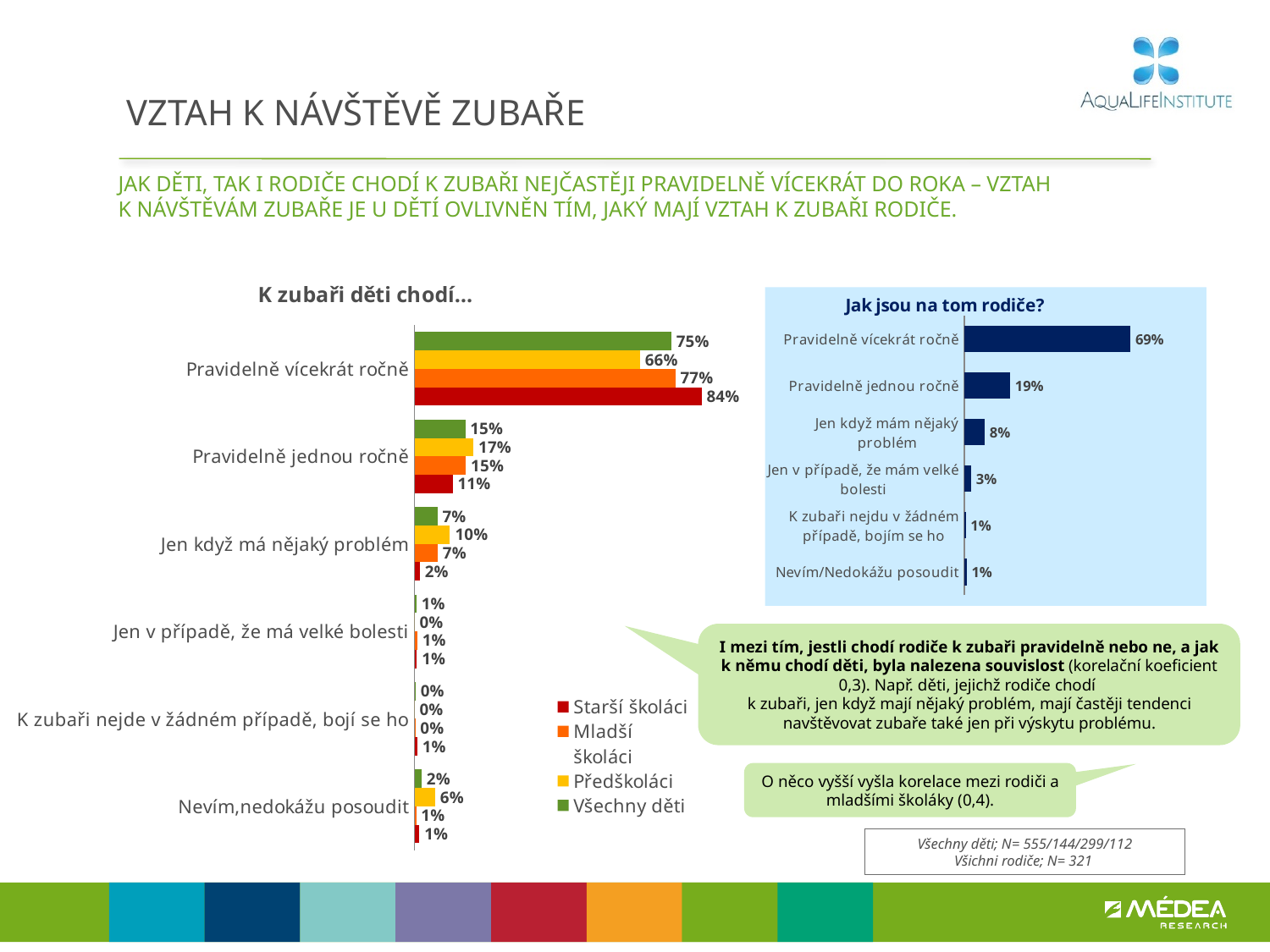
In the chart 'K zubaři děti chodí…', what is the difference between 'Mladší školáci' and 'Předškoláci' for 'Pravidelně vícekrát ročně'? 11% In the chart 'K zubaři děti chodí…', which series has the highest value for 'Pravidelně vícekrát ročně'? Starší školáci In the chart 'K zubaři děti chodí…', how many series does the legend list? 4 In the chart 'Jak jsou na tom rodiče?', which category has the highest value? Pravidelně vícekrát ročně In the chart 'Jak jsou na tom rodiče?', what is the value for 'Jen když mám nějaký problém'? 8% In the chart 'K zubaři děti chodí…', what is the value for 'Starší školáci' in 'Pravidelně vícekrát ročně'? 84% In the chart 'K zubaři děti chodí…', what is the value for 'Předškoláci' in 'Nevím,nedokážu posoudit'? 6% In the chart 'Jak jsou na tom rodiče?', what is the value for 'Pravidelně vícekrát ročně'? 69% In the chart 'K zubaři děti chodí…', which is larger for 'Jen když má nějaký problém': 'Předškoláci' or 'Starší školáci'? Předškoláci In the chart 'Jak jsou na tom rodiče?', how many categories are shown? 6 In the chart 'Jak jsou na tom rodiče?', what is the difference between 'Pravidelně vícekrát ročně' and 'Pravidelně jednou ročně'? 50% What type of chart is 'K zubaři děti chodí…'? Bar chart